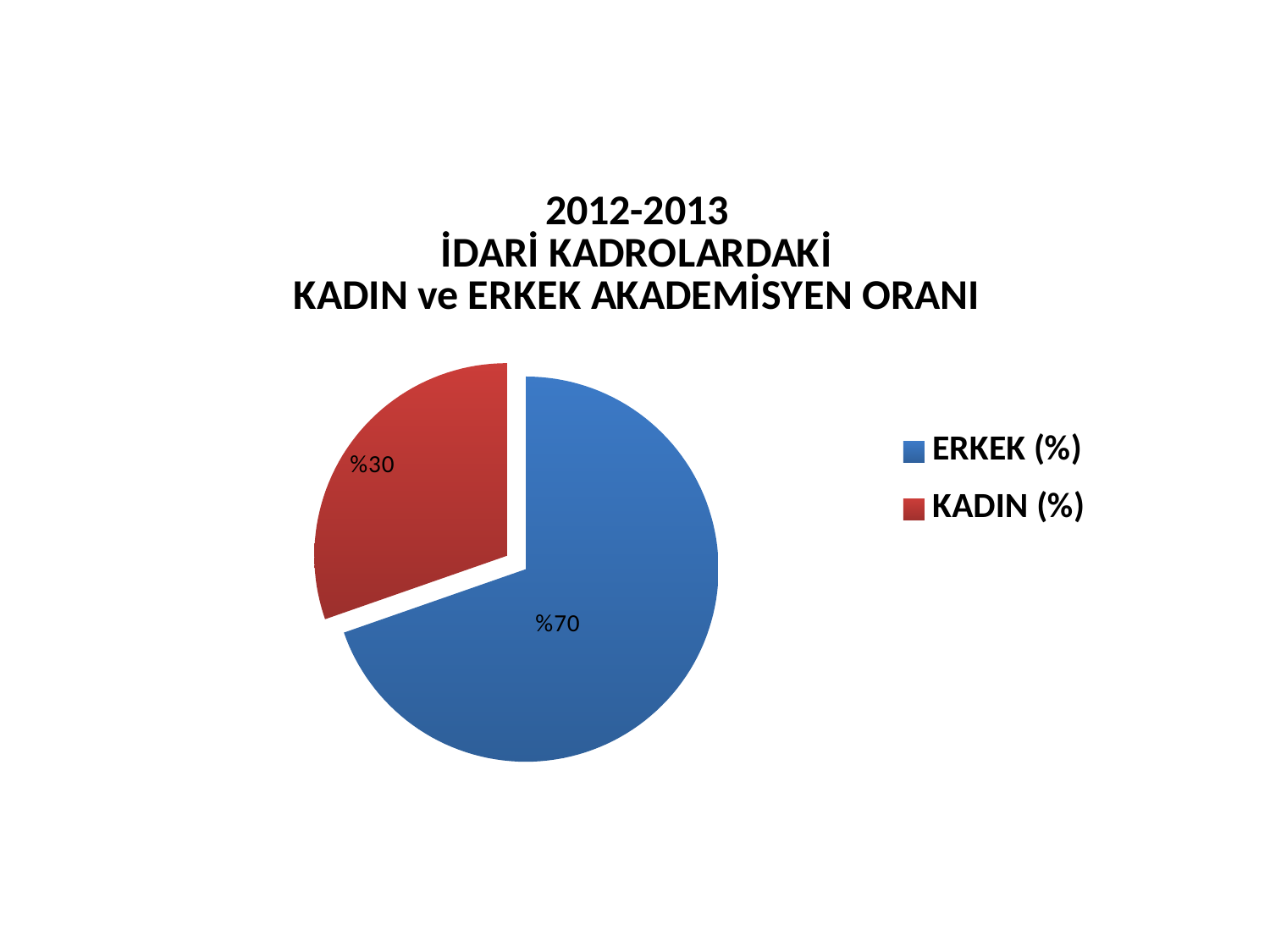
What is the value shown for ERKEK (%)? %70 Which is larger, the ERKEK (%) slice or the KADIN (%) slice? ERKEK (%) What is the value shown for KADIN (%)? %30 Which category has the largest slice of the pie? ERKEK (%) Which category has the smallest slice of the pie? KADIN (%) What share of the pie does the KADIN (%) slice represent? %30 What is the difference between the ERKEK (%) and KADIN (%) values? %40 What colour is the ERKEK (%) slice? blue What kind of chart is shown on the slide? pie chart Which years does the chart title refer to? 2012-2013 How many entries does the legend list? 2 How many slices does the pie chart have? 2